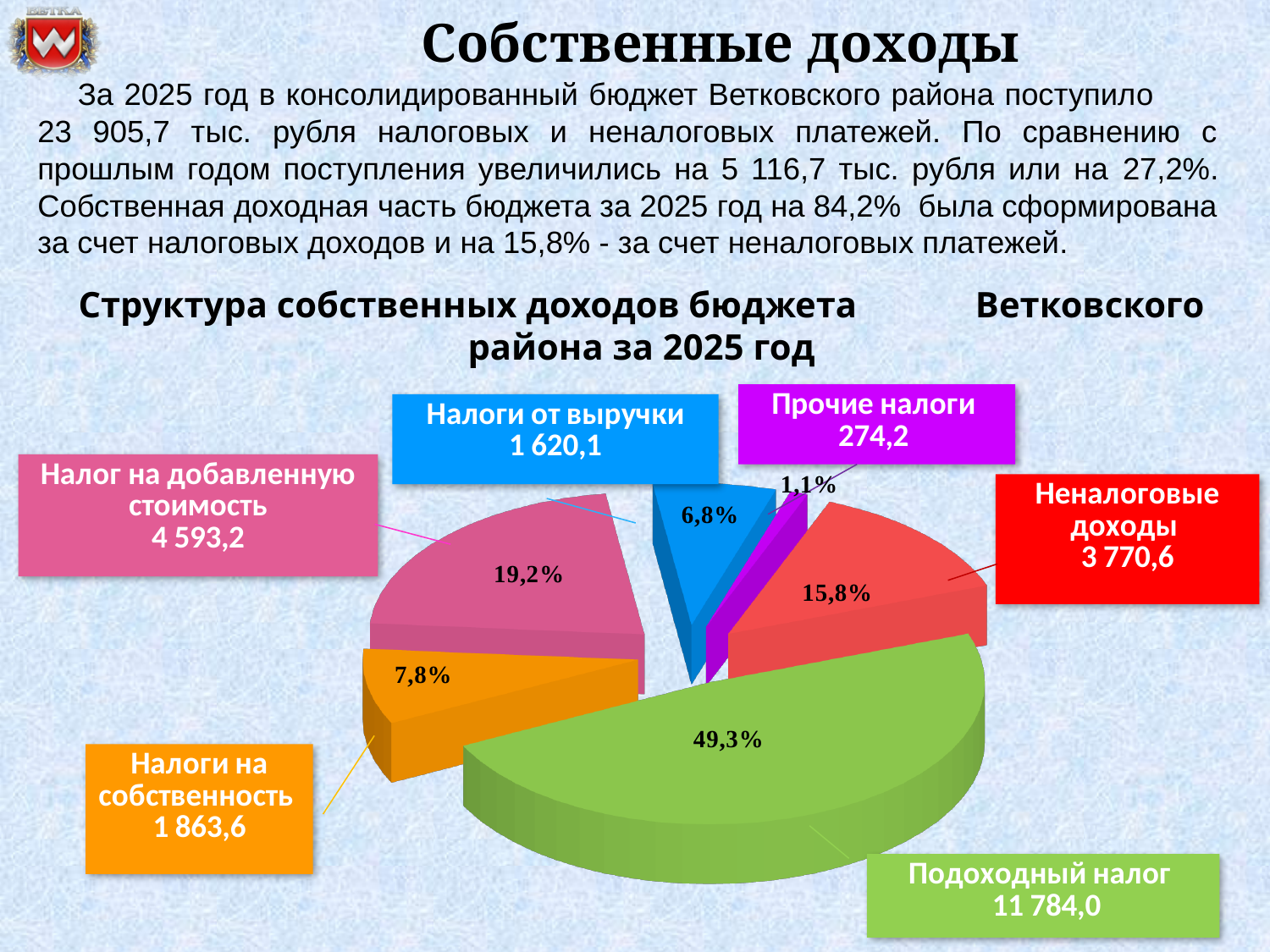
What is the value shown for Неналоговые доходы? 3 770,6 What is the value shown for Прочие налоги? 274,2 What is the difference between the values for Налог на добавленную стоимость and Неналоговые доходы? 822,6 How many slices does the pie chart have? 6 What share of the pie does Налоги на собственность represent? 7,8% What is the value shown for Налог на добавленную стоимость? 4 593,2 What kind of chart is shown on the slide? pie chart What share of the pie does Подоходный налог represent? 49,3% What is the value shown for Подоходный налог? 11 784,0 Which category has the largest slice of the pie? Подоходный налог Which category has the smallest slice of the pie? Прочие налоги Which is larger, Налоги на собственность or Налоги от выручки? Налоги на собственность